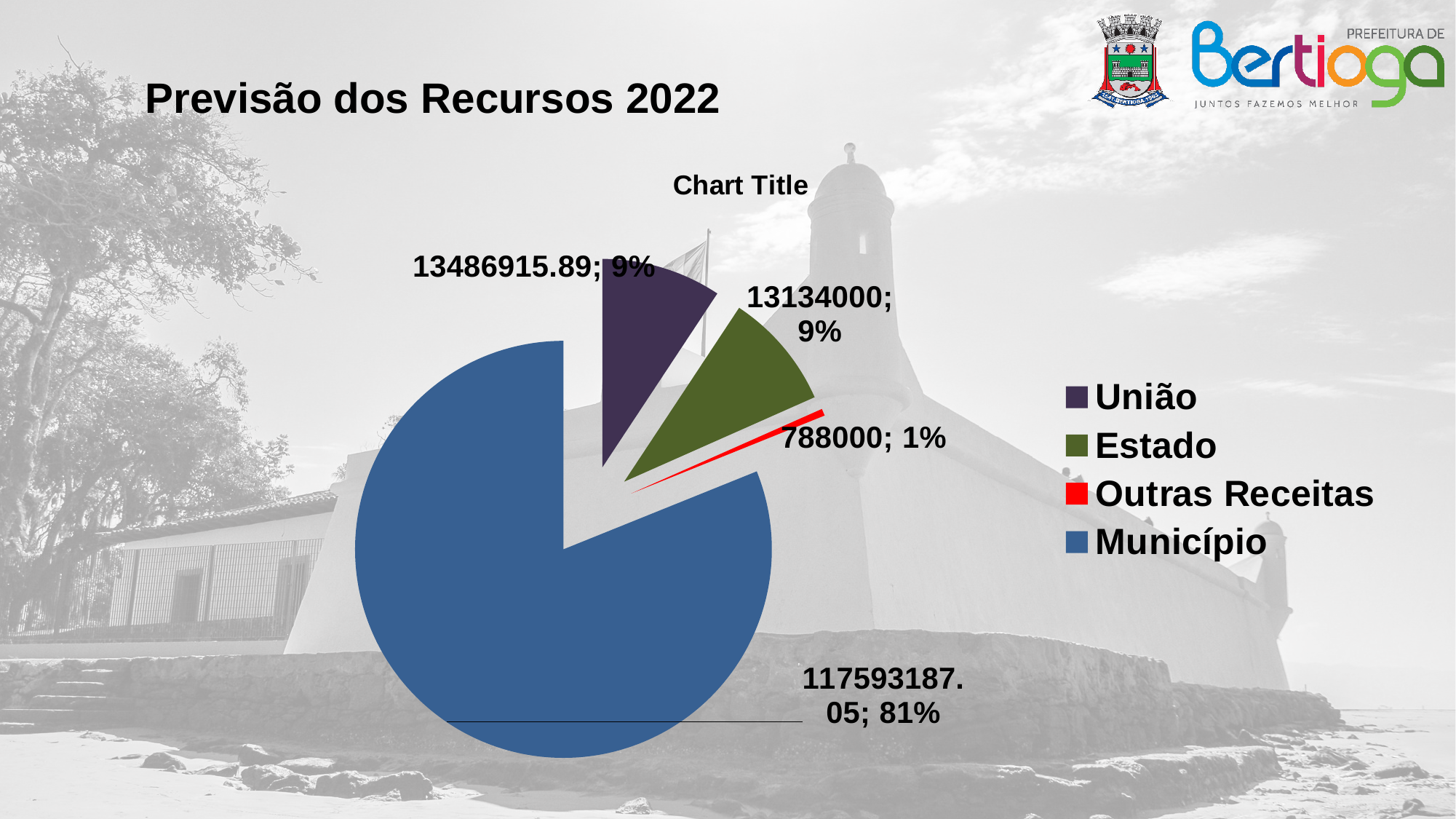
Which has the larger value, União or Estado? União Which category has the smallest slice of the pie? Outras Receitas What share of the pie does Outras Receitas represent? 1% What is the value shown for Outras Receitas? 788000 What is the value shown for Estado? 13134000 How many categories does the legend list? 4 What colour is the slice for Outras Receitas? red Which category has the largest slice of the pie? Município What is the value shown for Município? 117593187.05 What is the value shown for União? 13486915.89 What type of chart is shown on the slide? pie chart What share of the pie does Município represent? 81%